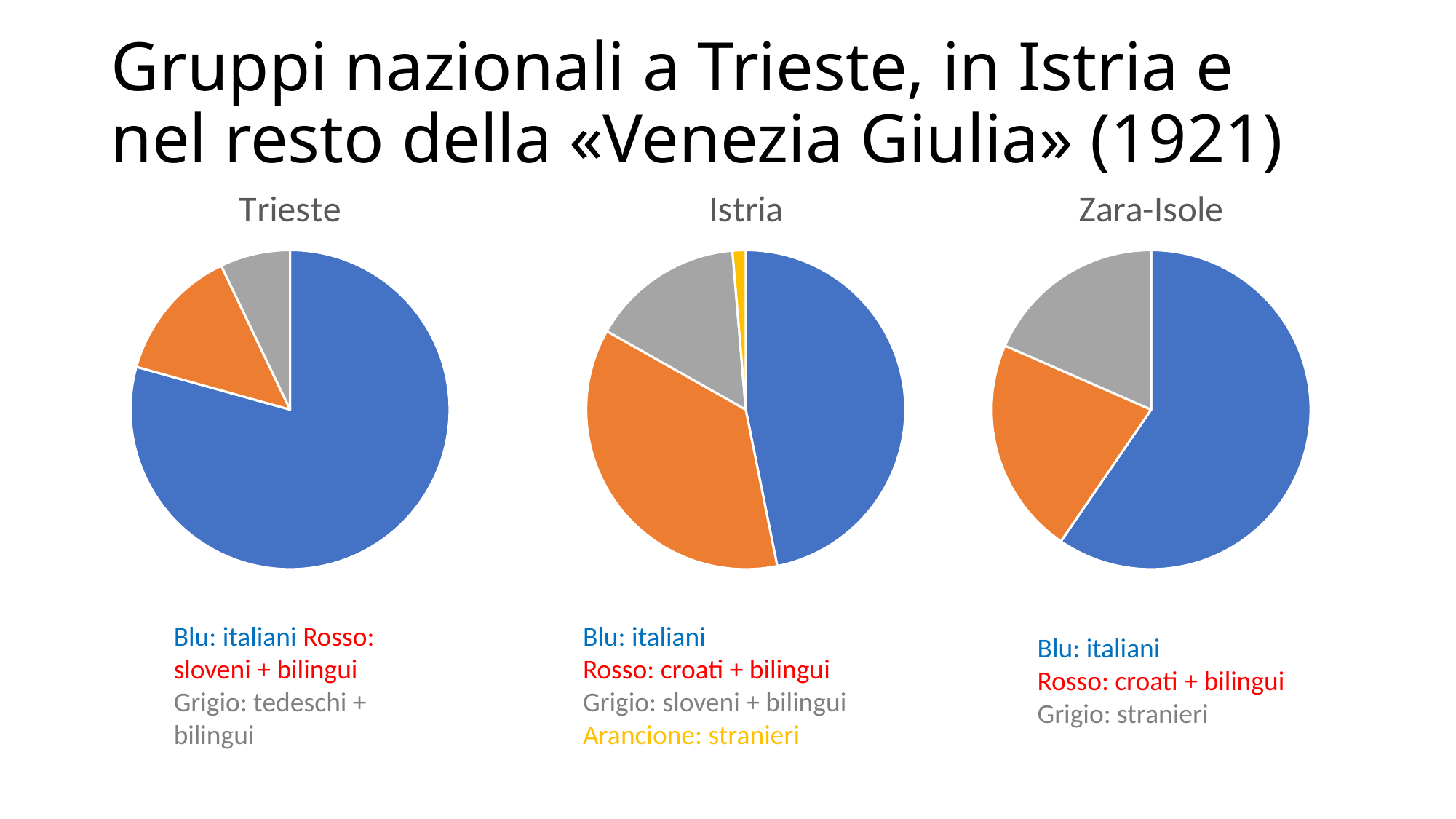
In the Istria chart, which colour represents stranieri? Arancione (orange/yellow) In the Istria chart, which group has the largest slice? italiani In the Trieste chart, which group has the largest slice? italiani In the Istria chart, which slice is larger: croati + bilingui or sloveni + bilingui? croati + bilingui In the Istria chart, which group has the smallest slice? stranieri How many slices does the Zara-Isole pie chart have? 3 How many slices does the Istria pie chart have? 4 In the Trieste chart, which group has the smallest slice? tedeschi + bilingui How many slices does the Trieste pie chart have? 3 What kind of chart is used for Trieste? pie chart In the Trieste chart, which slice is larger: sloveni + bilingui or tedeschi + bilingui? sloveni + bilingui In the Zara-Isole chart, which group has the largest slice? italiani